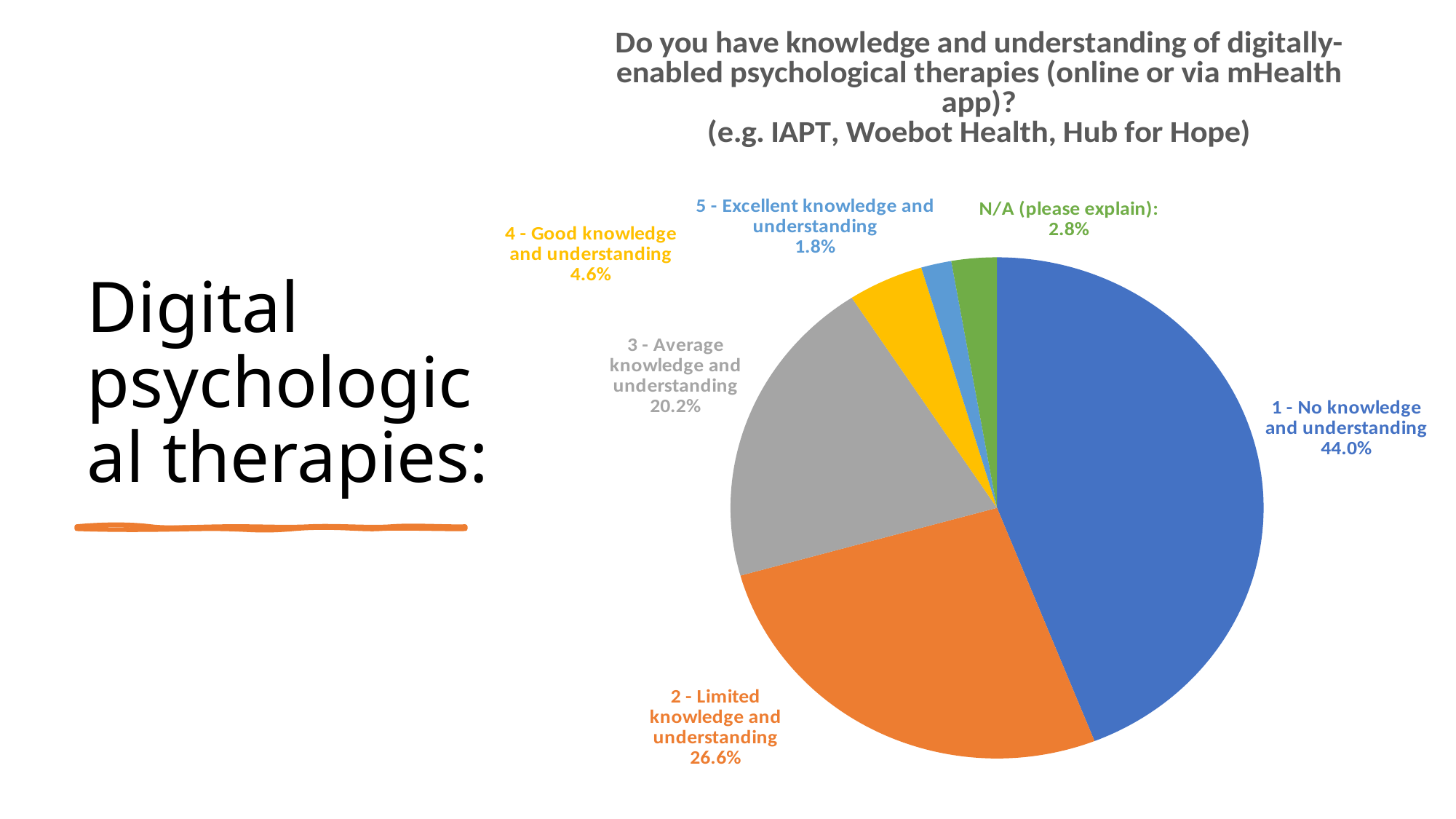
What share of respondents selected "5 - Excellent knowledge and understanding"? 1.8% What is the difference in percentage points between "1 - No knowledge and understanding" and "2 - Limited knowledge and understanding"? 17.4 Which category has the smallest slice of the pie? 5 - Excellent knowledge and understanding Which category has the largest slice of the pie? 1 - No knowledge and understanding What share of respondents selected "N/A (please explain):"? 2.8% Which is larger: the share for "4 - Good knowledge and understanding" or the share for "N/A (please explain):"? 4 - Good knowledge and understanding What share of respondents selected "1 - No knowledge and understanding"? 44.0% What share of respondents selected "3 - Average knowledge and understanding"? 20.2% What share of respondents selected "4 - Good knowledge and understanding"? 4.6% What kind of chart is shown on the slide? Pie chart How many categories (slices) does the pie chart have? 6 What share of respondents selected "2 - Limited knowledge and understanding"? 26.6%